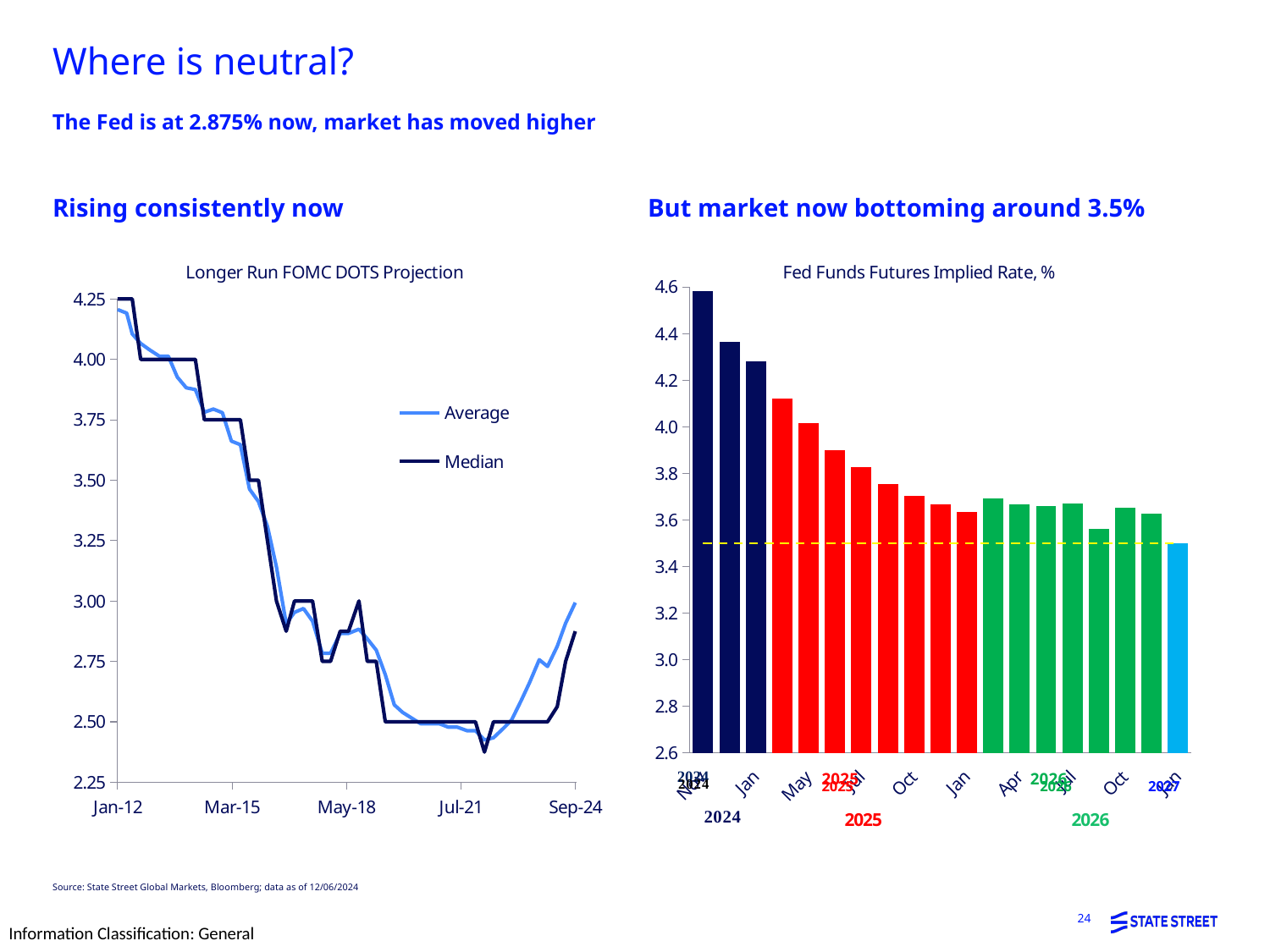
What type of chart is the left chart titled 'Longer Run FOMC DOTS Projection'? line chart In the left chart 'Longer Run FOMC DOTS Projection', do the values overall rise or fall from Jan-12 to Jul-21? fall In the right chart 'Fed Funds Futures Implied Rate, %', which month has the highest bar? Nov 2024 In the right chart 'Fed Funds Futures Implied Rate, %', is the value for Nov 2024 greater or less than 4.4? greater What type of chart is the right chart titled 'Fed Funds Futures Implied Rate, %'? bar chart In the left chart 'Longer Run FOMC DOTS Projection', is the Median value at Sep-24 greater or less than 3.00? less In the left chart 'Longer Run FOMC DOTS Projection', is the Median value at Jan-12 greater or less than 4.00? greater In the left chart 'Longer Run FOMC DOTS Projection', what are the two series named in the legend? Average and Median How many series does the legend of the left chart 'Longer Run FOMC DOTS Projection' list? 2 In the left chart 'Longer Run FOMC DOTS Projection', is the Median value higher at Jan-12 or at Sep-24? Jan-12 In the right chart 'Fed Funds Futures Implied Rate, %', do the bars generally rise or fall from Nov 2024 to Jan 2027? fall